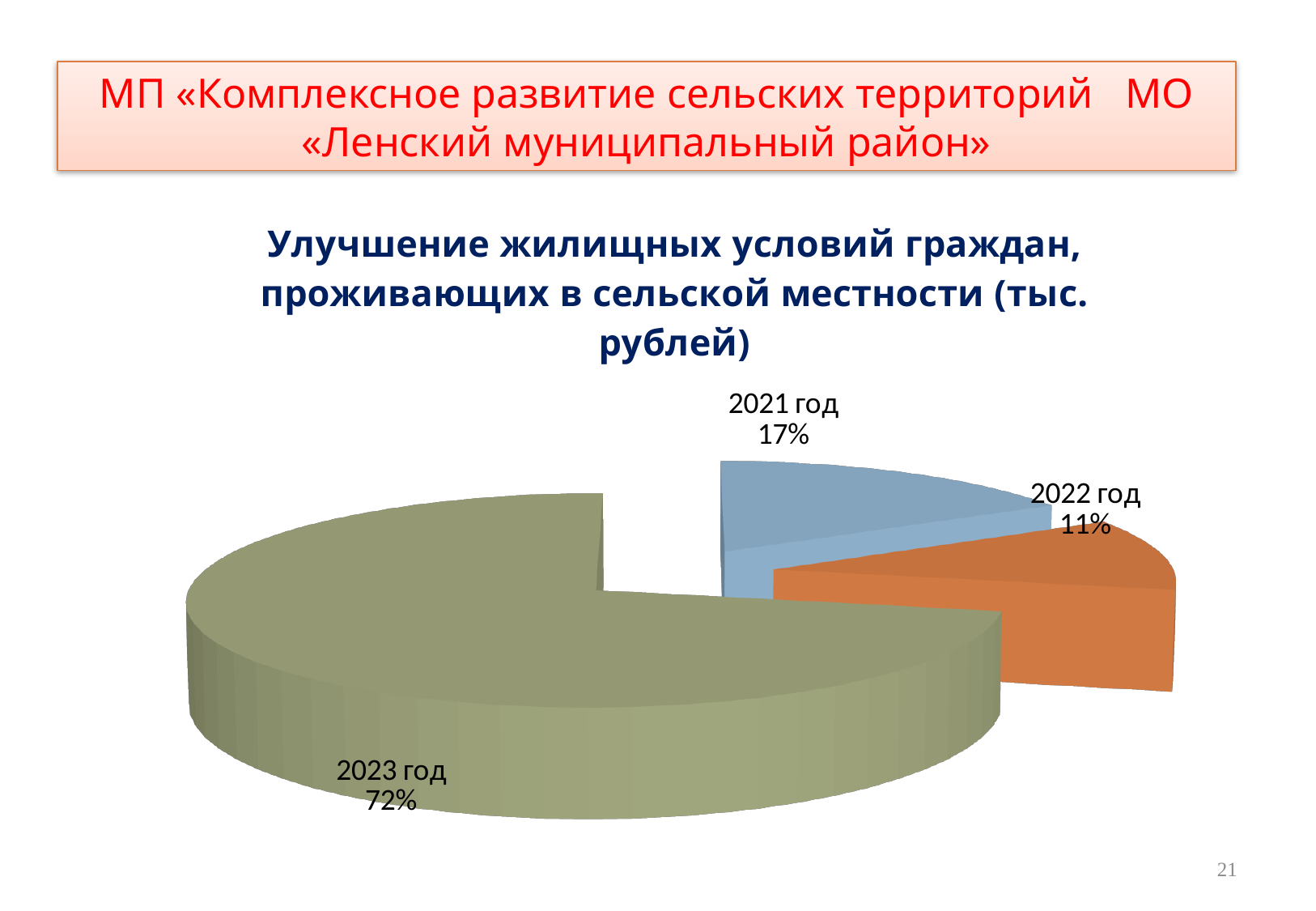
What share of the pie does 2023 год have? 72% What is the title of the chart? Улучшение жилищных условий граждан, проживающих в сельской местности (тыс. рублей) Which year has the largest slice of the pie? 2023 год What is the difference in percentage points between the 2023 год slice and the 2021 год slice? 55 Which year has the smallest slice of the pie? 2022 год What is the difference in percentage points between the 2021 год slice and the 2022 год slice? 6 What kind of chart is shown on the slide? pie chart How many slices does the pie chart have? 3 What share of the pie does 2021 год have? 17% What share of the pie does 2022 год have? 11% Which slice is larger, 2021 год or 2022 год? 2021 год What colour is the slice for 2022 год? orange